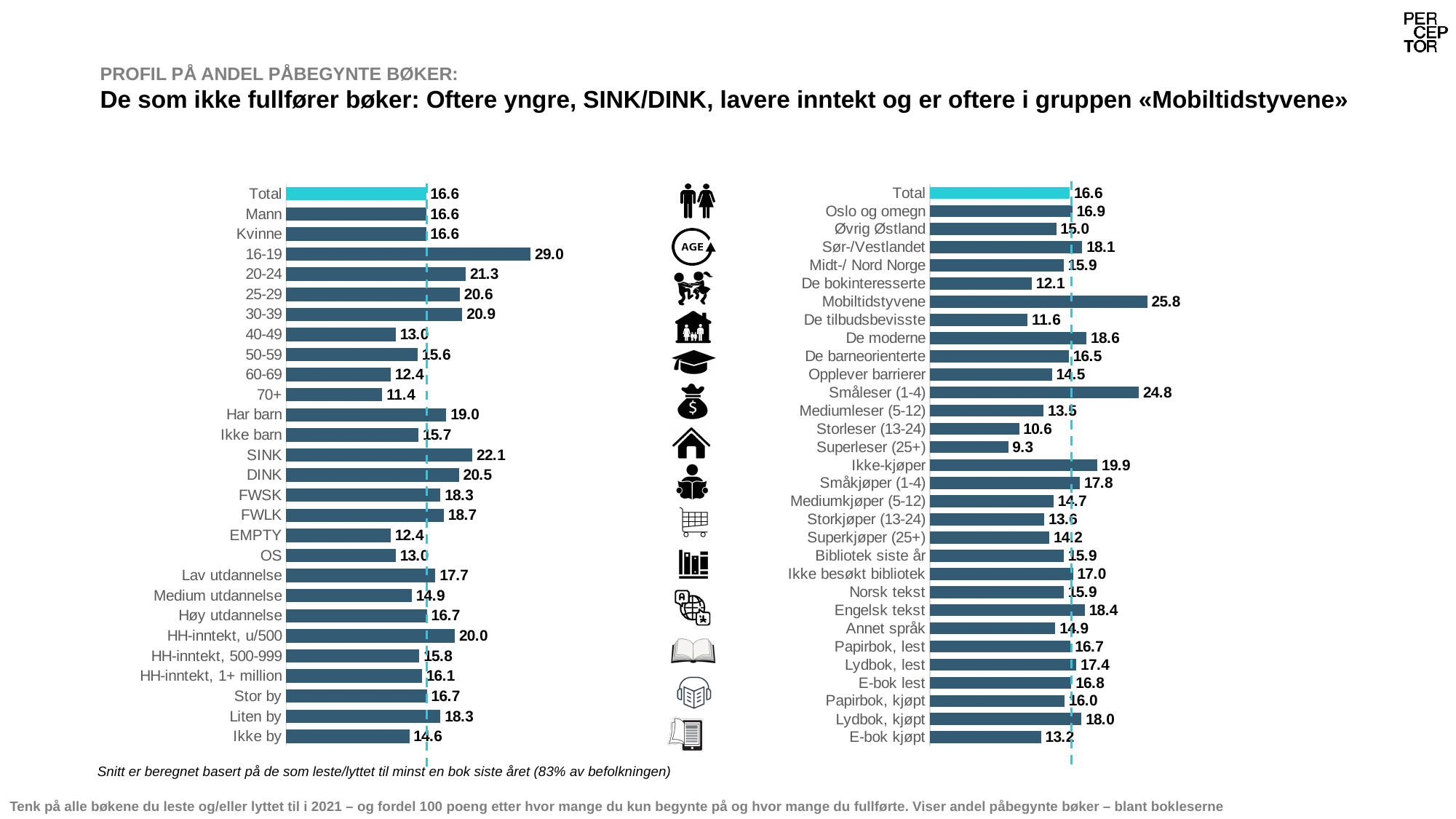
In the right chart, which category has the highest value? Mobiltidstyvene In the right chart, which category has the lowest value? Superleser (25+) In the left chart, what is the difference between Har barn and Ikke barn? 3.3 In the left chart, what is the value for 16-19? 29.0 In the right chart, which is larger, Lydbok, kjøpt or E-bok kjøpt? Lydbok, kjøpt In the left chart, which is larger, Liten by or Stor by? Liten by In the right chart, what is the difference between Småleser (1-4) and Storleser (13-24)? 14.2 In the left chart, what is the value for SINK? 22.1 In the left chart, which category has the lowest value? 70+ What kind of chart is the left chart? Bar chart In the right chart, what is the value for Mobiltidstyvene? 25.8 How many categories are plotted in the right chart? 31